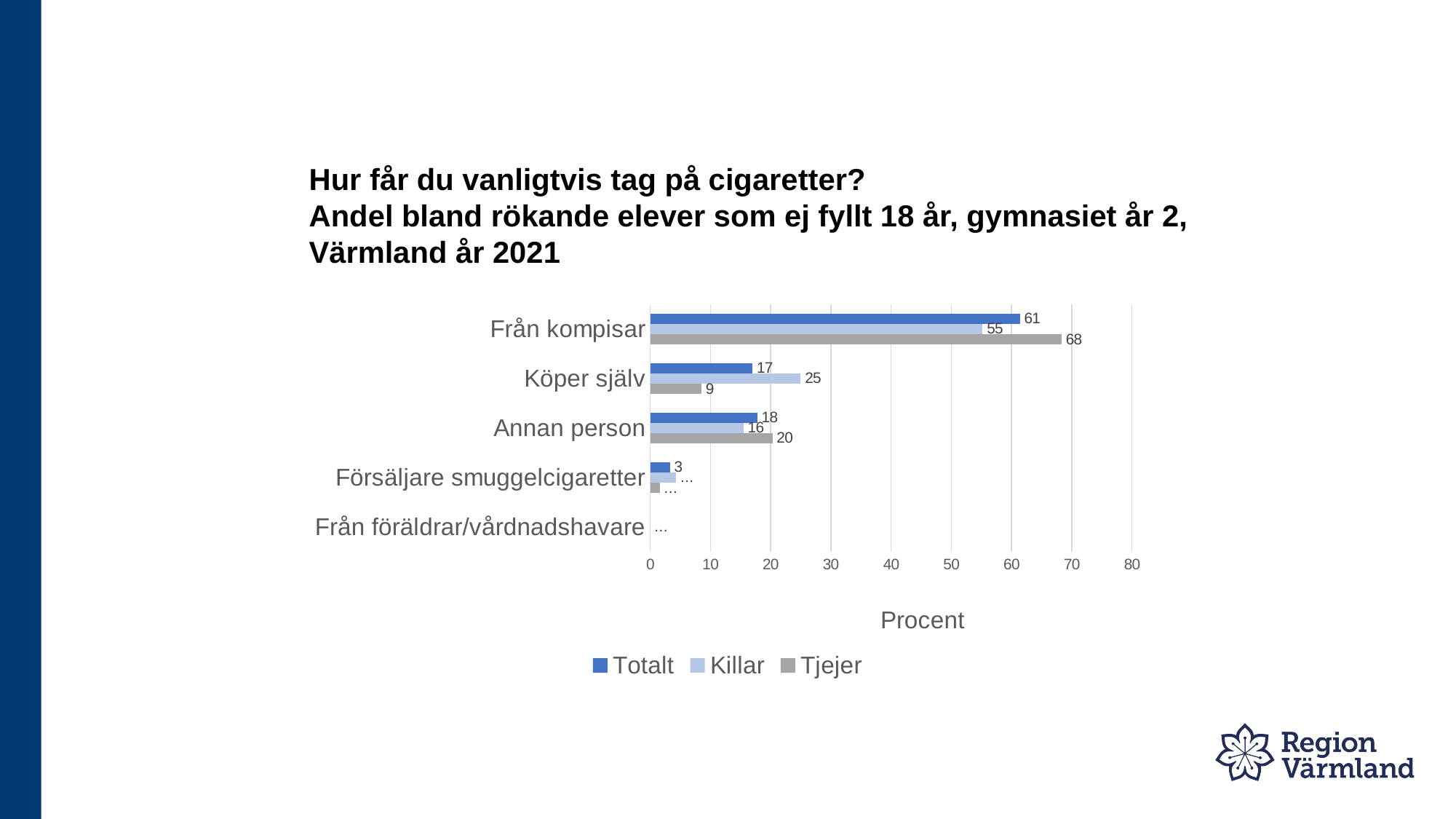
What is the Tjejer value for Från kompisar? 68 For Köper själv, which is larger: the Killar value or the Tjejer value? Killar Which category has the lowest Tjejer value among those with printed labels? Köper själv Which category has the highest Totalt value? Från kompisar Is the Totalt value for Från kompisar greater or less than 60? greater What is the difference between the Tjejer and Killar values for Från kompisar? 13 What is the Totalt value for Annan person? 18 What kind of chart is shown on the slide? Bar chart How many categories are shown on the y axis? 5 What is the Killar value for Köper själv? 25 How many series does the legend list? 3 What is the Totalt value for Försäljare smuggelcigaretter? 3